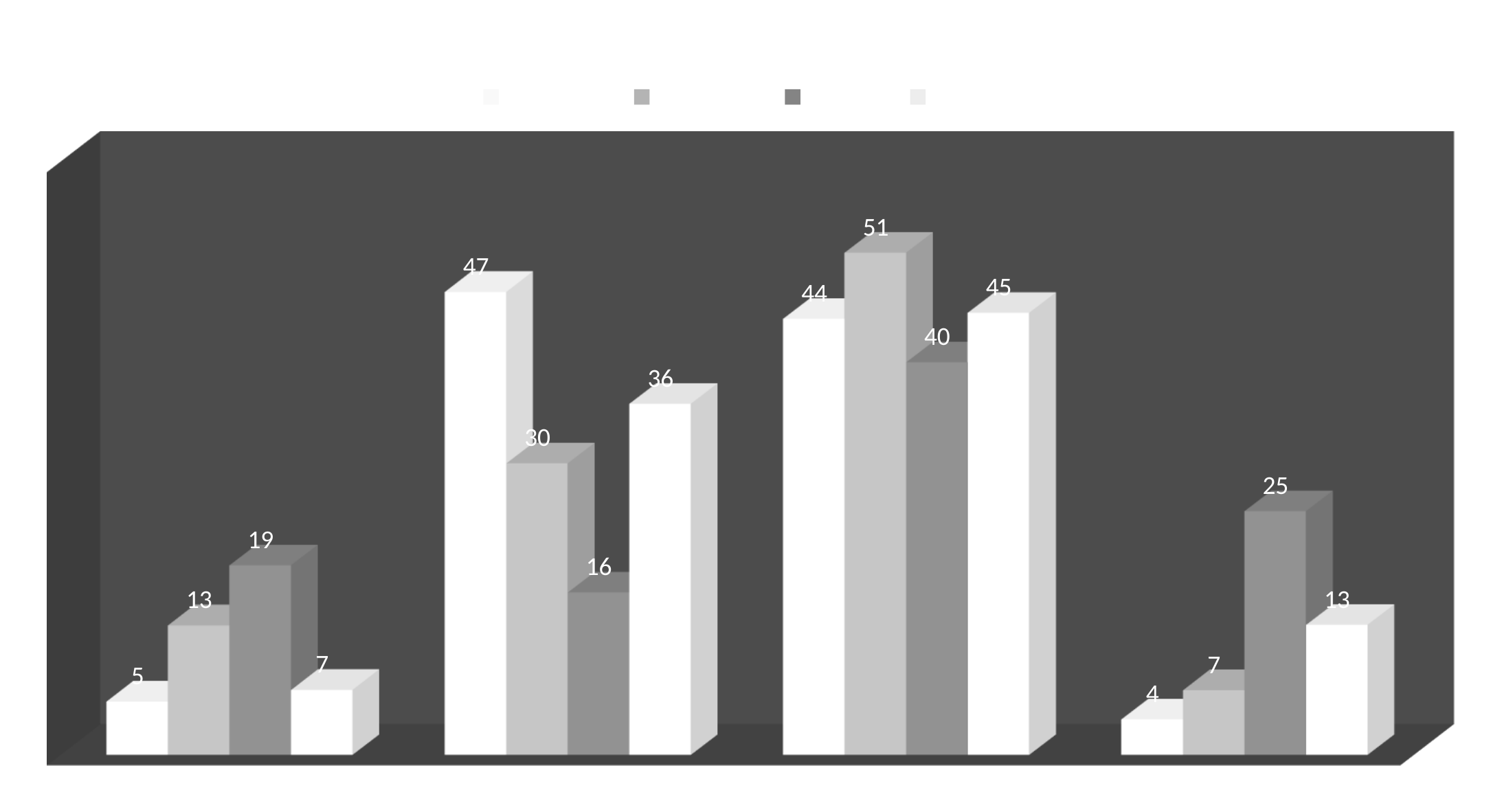
What is the value of the leftmost bar in the second group from the left? 47 How many series does the legend show? 4 What is the highest value labelled on the chart? 51 What is the value of the second bar in the third group from the left? 51 What kind of chart is shown on the slide? bar chart What is the value of the third bar in the fourth (rightmost) group? 25 In the second group from the left, which is larger: the first bar or the fourth bar? the first bar (47) In the third group from the left, what is the difference between the second bar (51) and the first bar (44)? 7 What is the value of the leftmost bar in the first group? 5 In the first group, what is the difference between the third bar (19) and the second bar (13)? 6 What is the lowest value labelled on the chart? 4 How many groups of bars are plotted along the x axis? 4